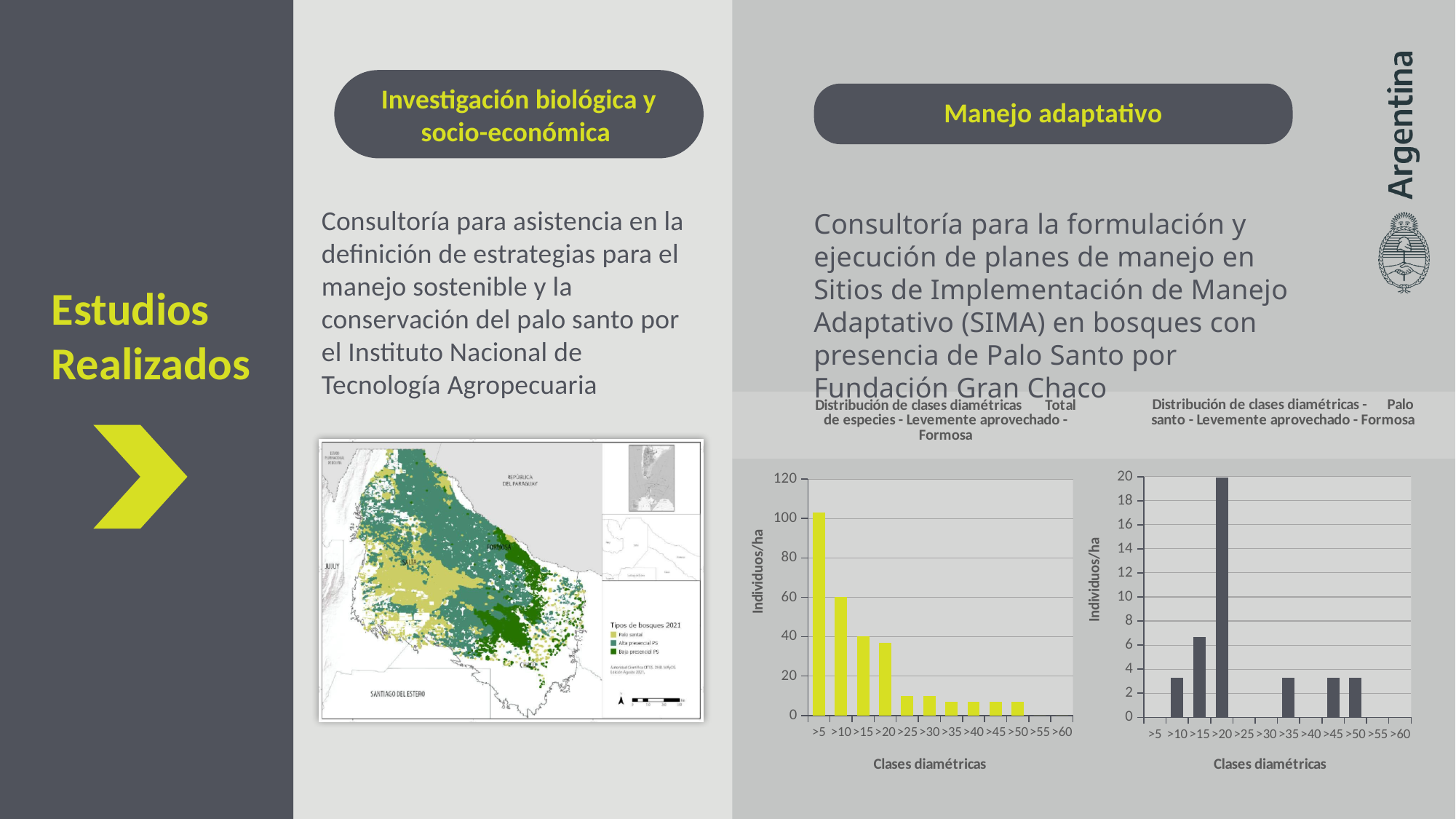
In the chart titled 'Distribución de clases diamétricas Total de especies - Levemente aprovechado - Formosa', which diametric class has the highest value? >5 What is the y-axis label of the chart titled 'Distribución de clases diamétricas - Palo santo - Levemente aprovechado - Formosa'? Individuos/ha In the chart titled 'Distribución de clases diamétricas Total de especies - Levemente aprovechado - Formosa', which is larger, the value for >5 or the value for >10? >5 In the chart titled 'Distribución de clases diamétricas - Palo santo - Levemente aprovechado - Formosa', which diametric class has the highest value? >20 In the chart titled 'Distribución de clases diamétricas - Palo santo - Levemente aprovechado - Formosa', is the value for >15 greater or less than 4? greater What kind of chart is the chart titled 'Distribución de clases diamétricas Total de especies - Levemente aprovechado - Formosa'? bar chart In the chart titled 'Distribución de clases diamétricas Total de especies - Levemente aprovechado - Formosa', do the values generally rise or fall from >5 to >50? fall In the chart titled 'Distribución de clases diamétricas - Palo santo - Levemente aprovechado - Formosa', which is larger, the value for >15 or the value for >20? >20 In the chart titled 'Distribución de clases diamétricas Total de especies - Levemente aprovechado - Formosa', is the value for >25 greater or less than 20? less How many diametric classes are shown on the x axis of the chart titled 'Distribución de clases diamétricas Total de especies - Levemente aprovechado - Formosa'? 12 In the chart titled 'Distribución de clases diamétricas - Palo santo - Levemente aprovechado - Formosa', is the value for >20 greater or less than 10? greater